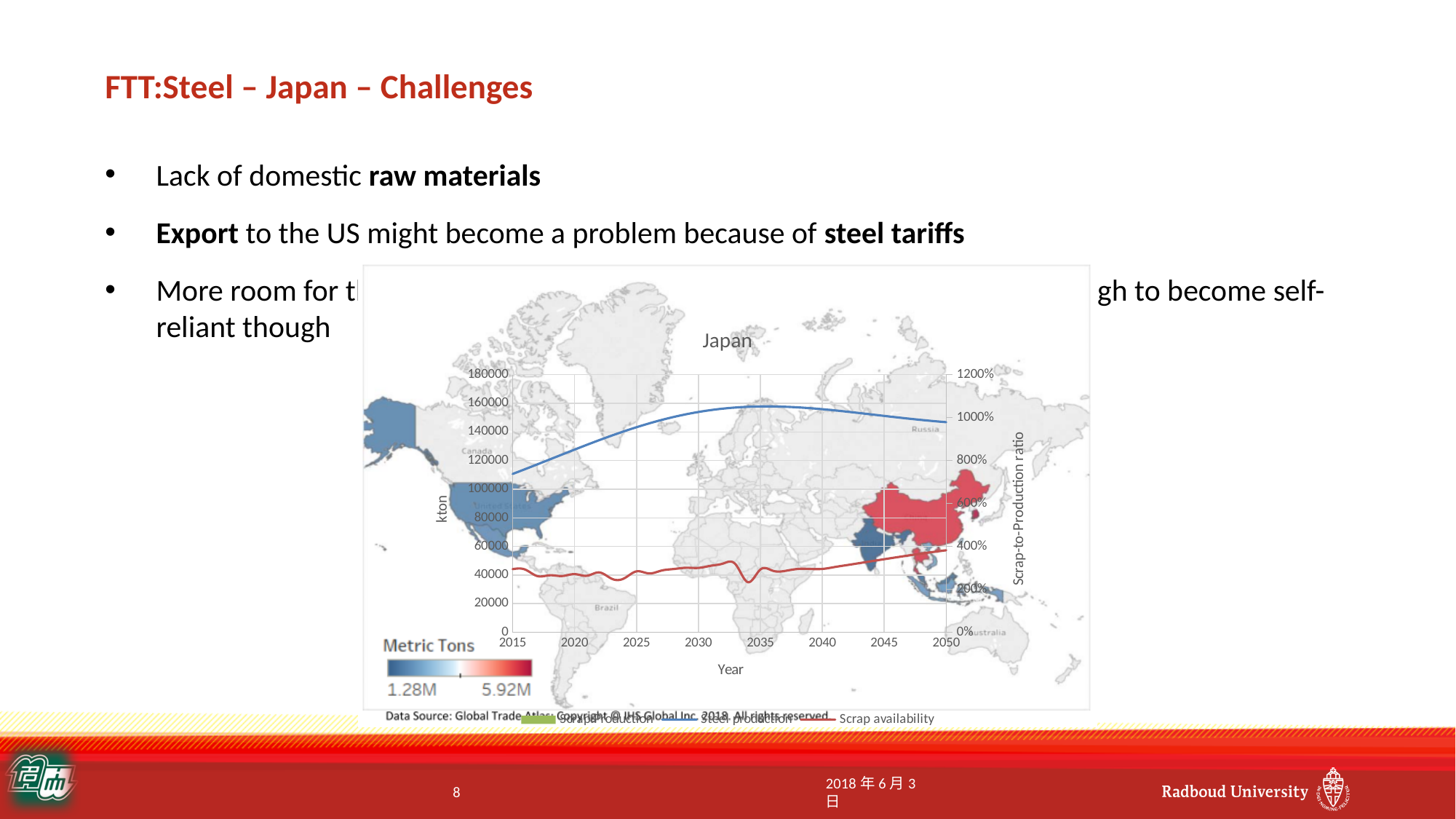
How many series does the legend of the "Japan" chart list? 3 In the "Japan" chart, does Steel production rise or fall between 2035 and 2050? fall In the "Japan" chart, does Steel production rise or fall between 2015 and 2035? rise What is the label of the right-hand vertical axis of the "Japan" chart? Scrap-to-Production ratio In the "Japan" chart, is the Steel production value for 2015 greater or less than 120000? less What is the title of the chart overlaid on the world map? Japan In the "Japan" chart, is the Steel production value for 2035 greater or less than 140000? greater What kind of chart is the "Japan" chart on the slide? line chart How many year ticks are labelled on the x axis of the "Japan" chart? 8 In the "Japan" chart, is the Steel production value for 2050 greater or less than 120000? greater In the "Japan" chart, is Scrap availability higher in 2015 or in 2050? 2050 In the "Japan" chart, is Steel production larger in 2015 or in 2035? 2035